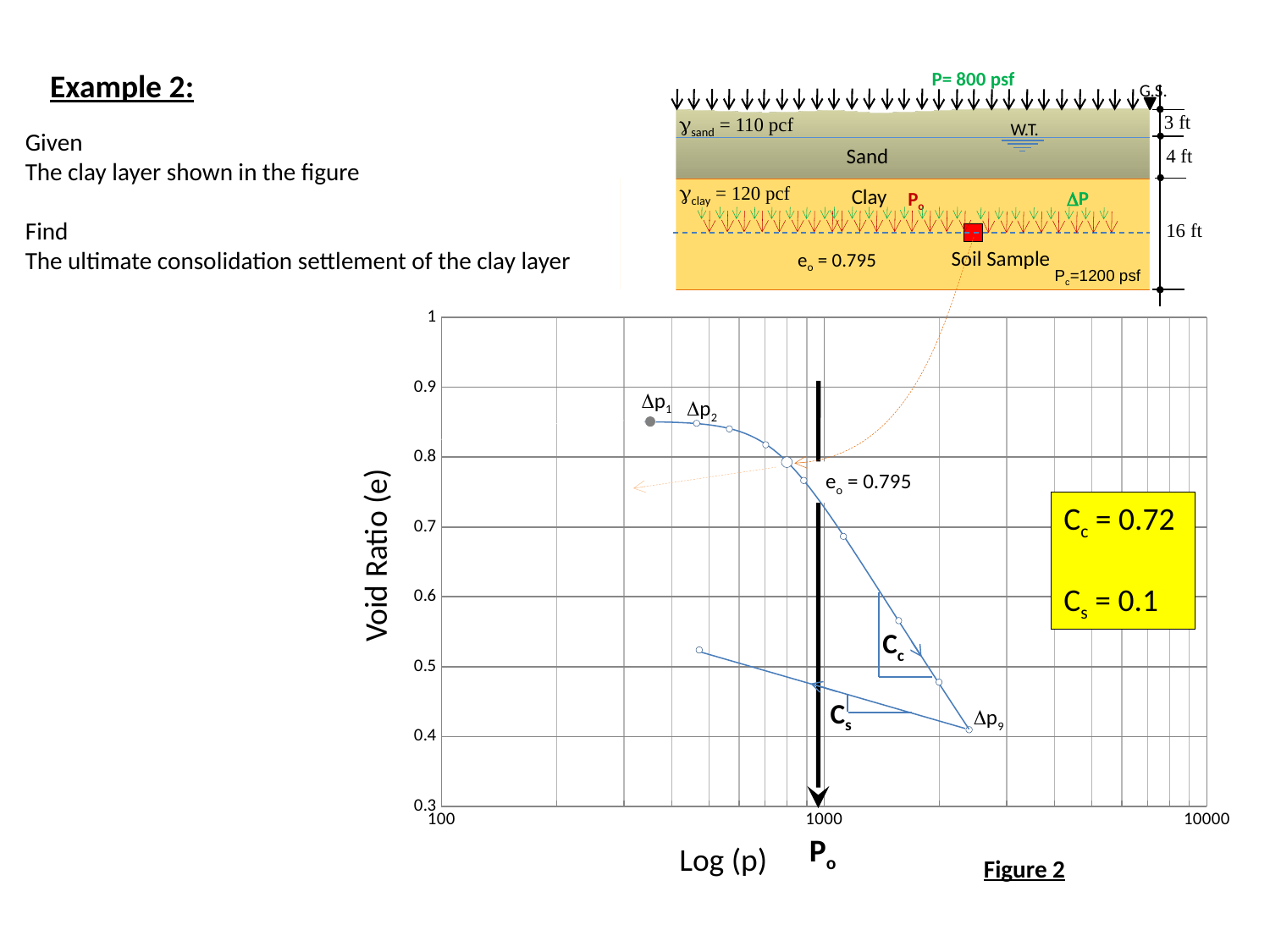
What kind of chart is shown on the slide? line chart What is the label of the x axis of the chart? Log (p) Along the main curve, does the void ratio rise or fall as p increases? fall Which point has the higher void ratio, Δp1 or Δp9? Δp1 What is the lowest value shown on the y axis of the chart? 0.3 What is the label of the y axis of the chart? Void Ratio (e) What value of e_o is labeled on the chart? 0.795 What value of C_c is given in the box on the chart? 0.72 What value of C_s is given in the box on the chart? 0.1 Is the void ratio at the point labeled Δp1 greater or less than 0.8? greater What is the highest value shown on the x axis of the chart? 10000 Is the void ratio at the point labeled Δp9 greater or less than 0.5? less